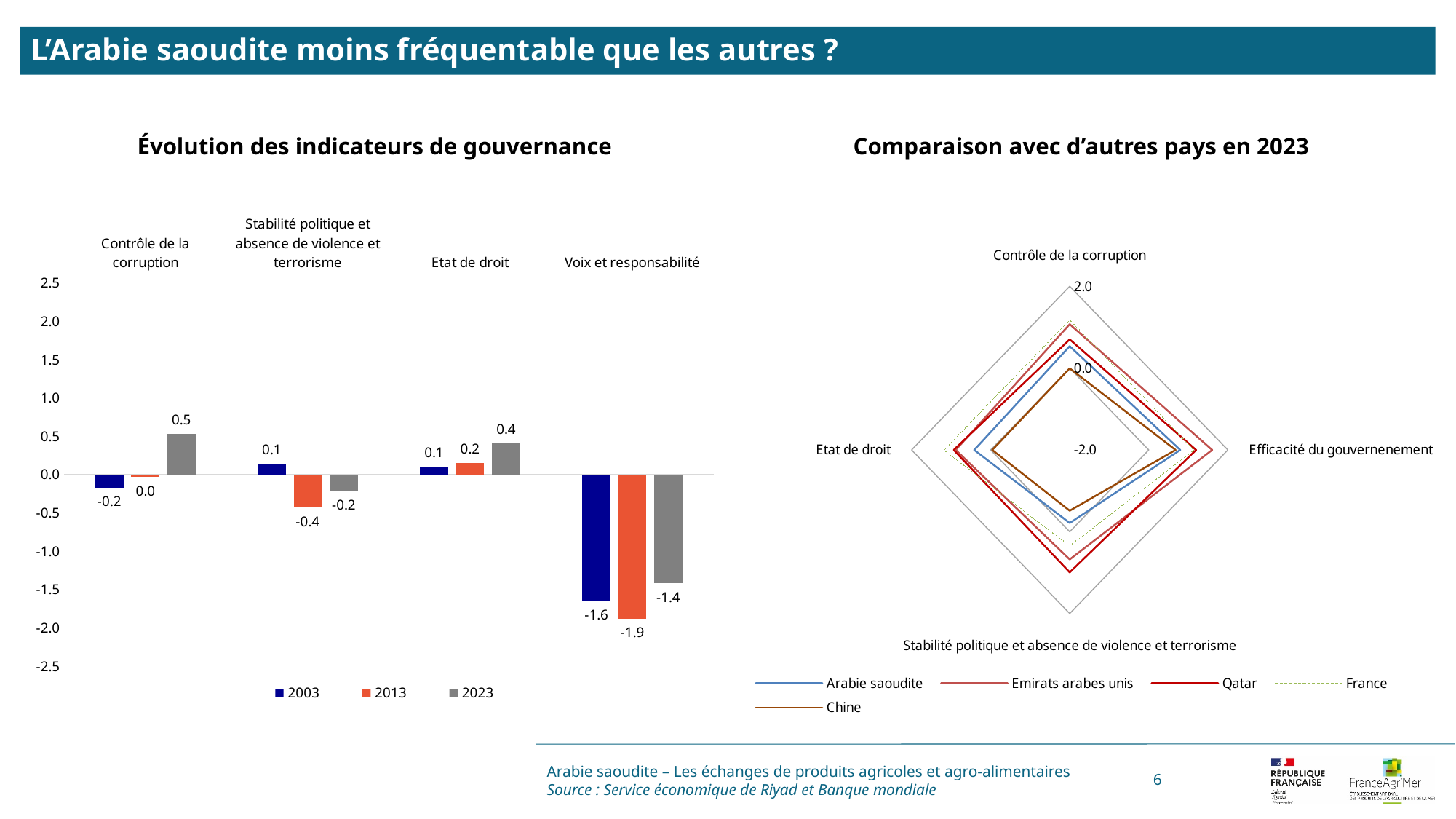
What kind of chart is 'Comparaison avec d'autres pays en 2023'? Radar chart In the chart 'Évolution des indicateurs de gouvernance', how many series does the legend list? 3 In the chart 'Évolution des indicateurs de gouvernance', what is the difference between the 2023 and 2003 values for 'Voix et responsabilité'? 0.2 In the chart 'Évolution des indicateurs de gouvernance', which category has the highest value in 2023? Contrôle de la corruption In the chart 'Évolution des indicateurs de gouvernance', which category has the lowest value in 2023? Voix et responsabilité In the chart 'Évolution des indicateurs de gouvernance', which is larger for 'Etat de droit': the 2013 value or the 2023 value? 2023 In the chart 'Évolution des indicateurs de gouvernance', what is the value for 'Voix et responsabilité' in 2013? -1.9 What kind of chart is 'Évolution des indicateurs de gouvernance'? Bar chart In the chart 'Comparaison avec d'autres pays en 2023', how many countries does the legend list? 5 In the chart 'Évolution des indicateurs de gouvernance', how many categories are shown on the x axis? 4 In the chart 'Évolution des indicateurs de gouvernance', what is the value for 'Stabilité politique et absence de violence et terrorisme' in 2013? -0.4 In the chart 'Évolution des indicateurs de gouvernance', what is the value for 'Contrôle de la corruption' in 2023? 0.5